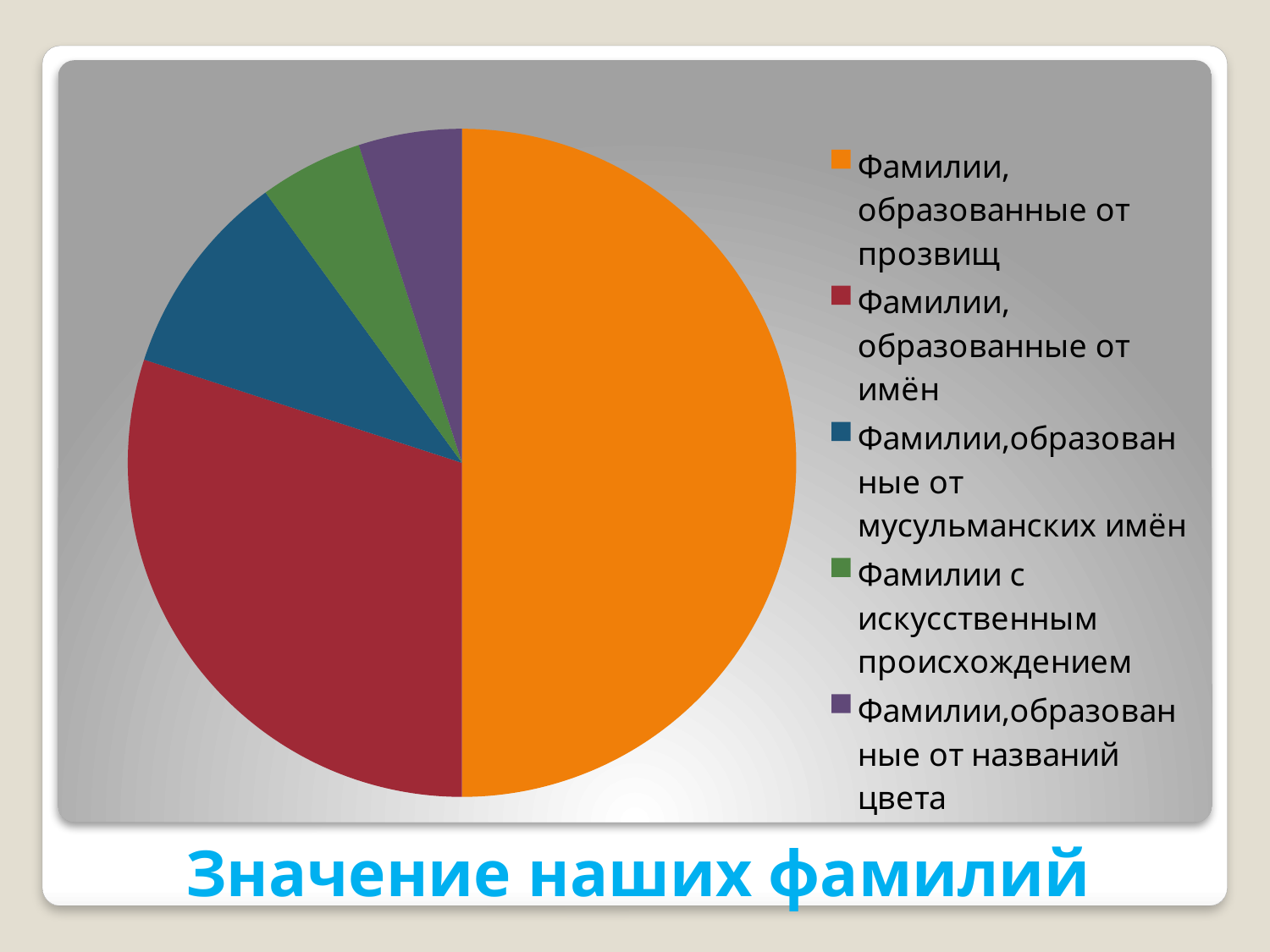
Which slice is larger: "Фамилии, образованные от прозвищ" or "Фамилии,образованные от названий цвета"? Фамилии, образованные от прозвищ Which slice is larger: "Фамилии, образованные от имён" or "Фамилии,образованные от мусульманских имён"? Фамилии, образованные от имён What is the title shown below the pie chart? Значение наших фамилий What colour is the slice for "Фамилии, образованные от имён"? red How many entries does the legend of the pie chart list? 5 What kind of chart is shown on the slide? pie chart Which slice is larger: "Фамилии, образованные от прозвищ" or "Фамилии, образованные от имён"? Фамилии, образованные от прозвищ Which category has the largest slice in the pie chart? Фамилии, образованные от прозвищ How many slices does the pie chart have? 5